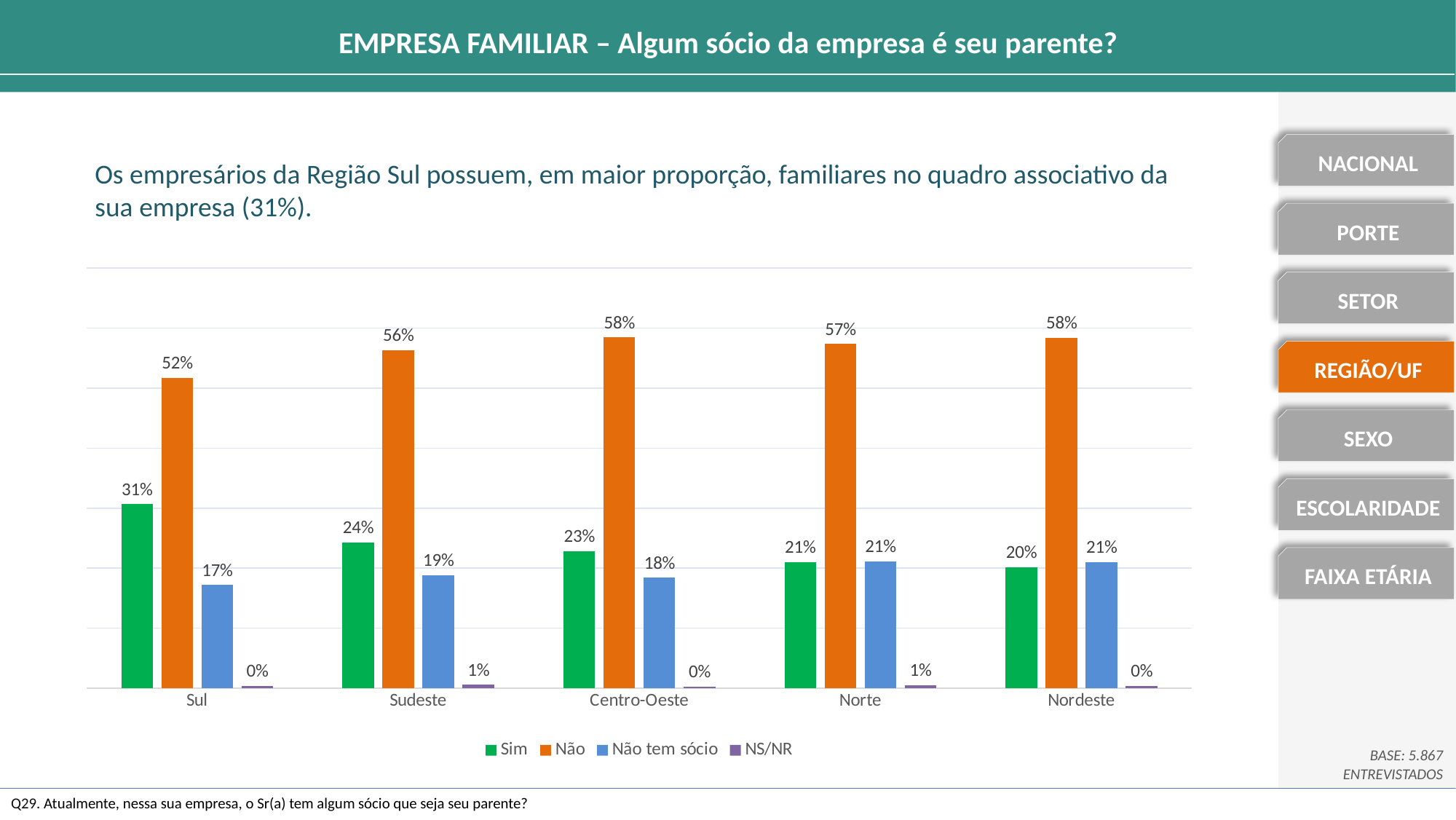
Which region has the highest value for the "Sim" series? Sul Which is larger: the "Sim" value for Sudeste or the "Sim" value for Nordeste? Sudeste How many regions are shown on the x axis of the chart? 5 What is the difference between the "Não" and "Sim" values for Sul? 21 percentage points How many series does the legend list? 4 Does the "Sim" series rise or fall from Sul to Nordeste along the x axis? Fall What is the value of the "Não tem sócio" series for Sudeste? 19% What is the value of the "Sim" series for Sul? 31% Which region has the lowest value for the "Não" series? Sul What is the value of the "Não" series for Norte? 57% What is the value of the "NS/NR" series for Centro-Oeste? 0% What kind of chart is shown on the slide? Bar chart